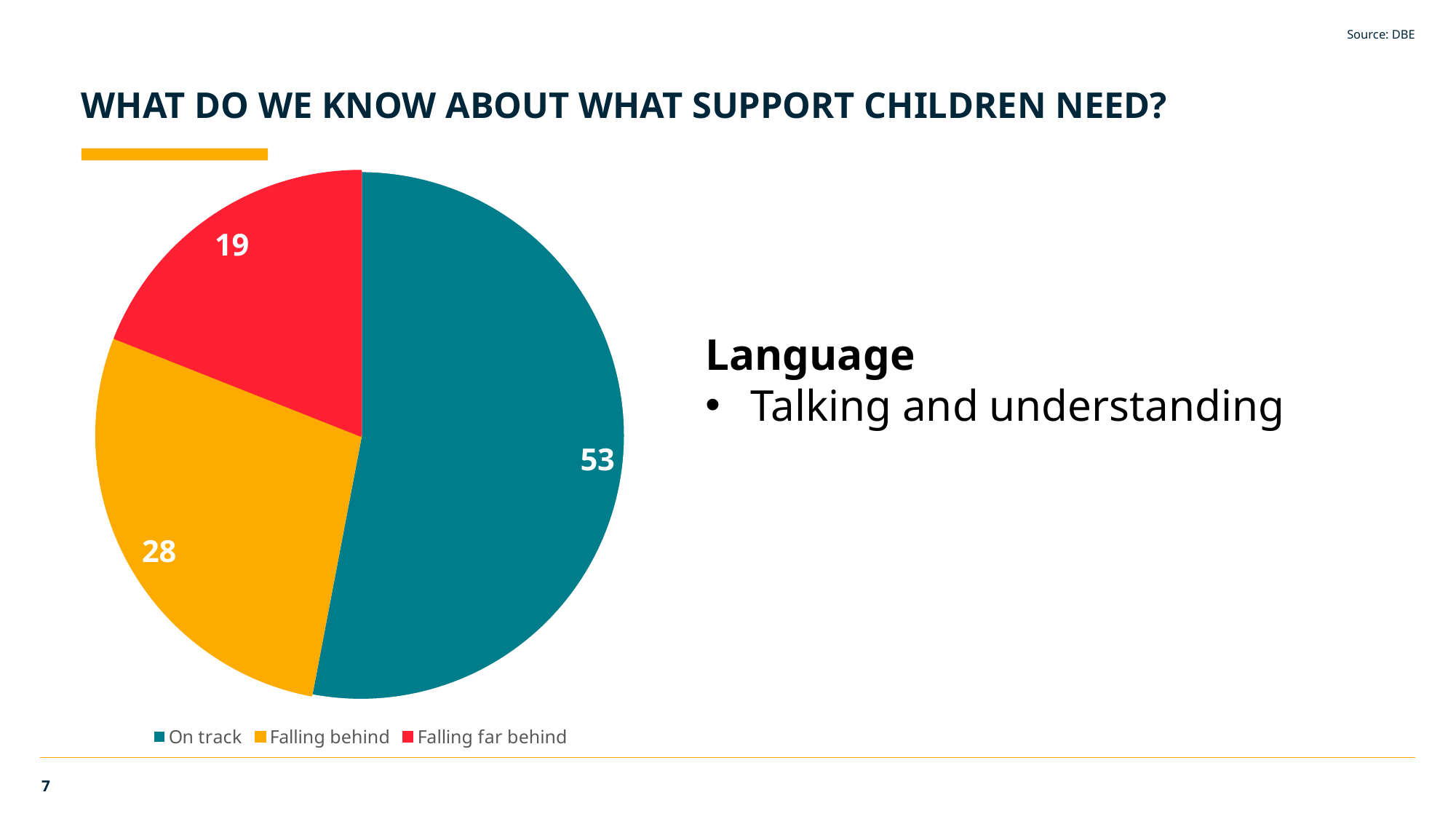
Which is larger, Falling behind or Falling far behind? Falling behind What is the difference between the On track and Falling behind values? 25 What kind of chart is shown on the slide? pie chart Which category has the largest slice? On track How many slices does the pie chart have? 3 What is the value for Falling far behind? 19 What is the value for On track? 53 What colour is the On track slice? teal Which category has the smallest slice? Falling far behind What is the difference between the Falling behind and Falling far behind values? 9 What is the value for Falling behind? 28 How many entries does the legend list? 3